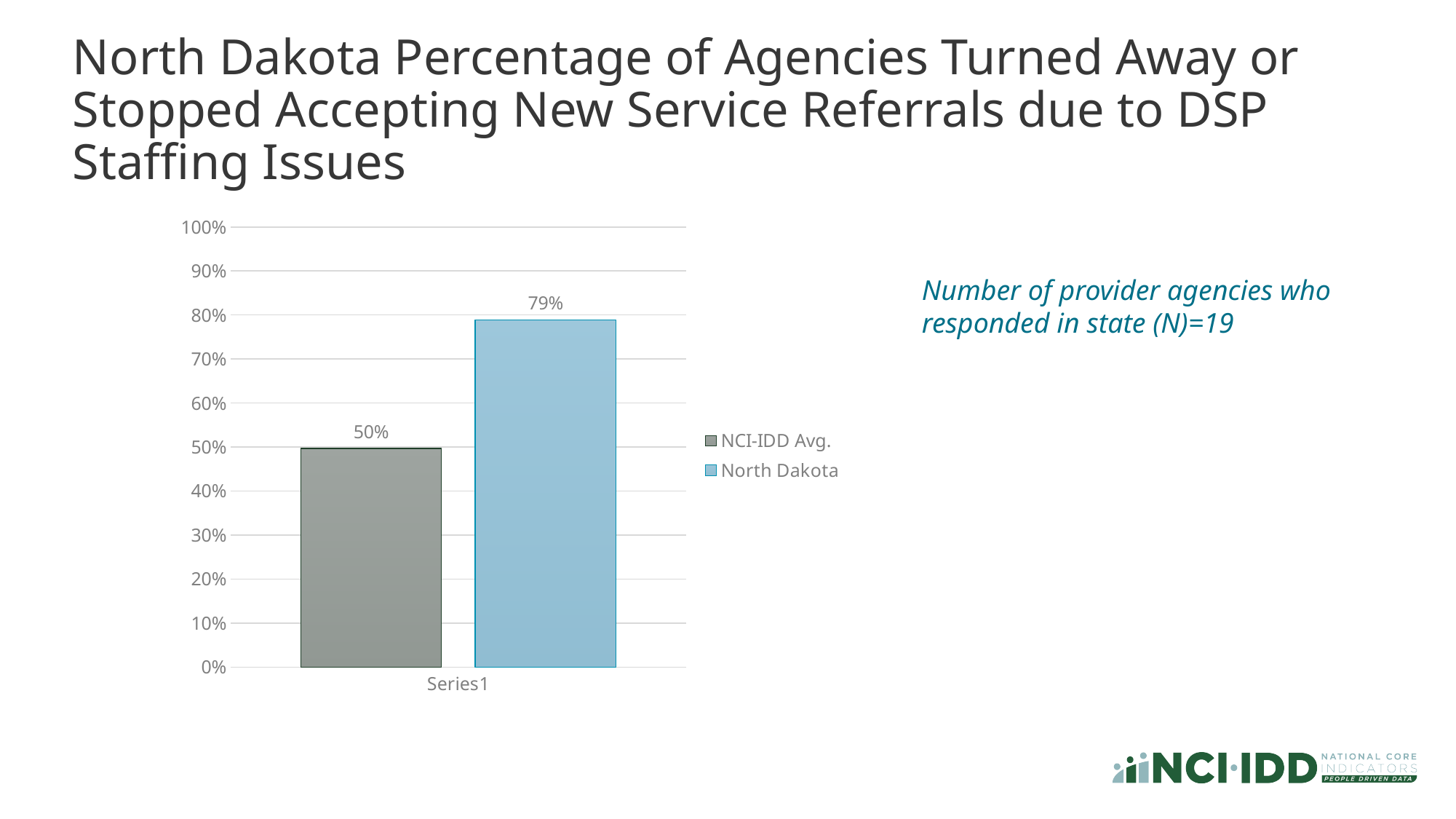
Which series has the lower value? NCI-IDD Avg. How many series does the legend list? 2 Which series has the higher value, NCI-IDD Avg. or North Dakota? North Dakota What is the label on the x axis under the bars? Series1 Is the value for North Dakota greater or less than 70%? greater What is the value for North Dakota? 79% What kind of chart is shown on the slide? bar chart Is the value for NCI-IDD Avg. greater or less than 60%? less What is the value for NCI-IDD Avg.? 50% Is the value for North Dakota larger or smaller than the value for NCI-IDD Avg.? larger What is the highest value shown on the y axis? 100% What is the difference between the North Dakota value and the NCI-IDD Avg. value? 29%